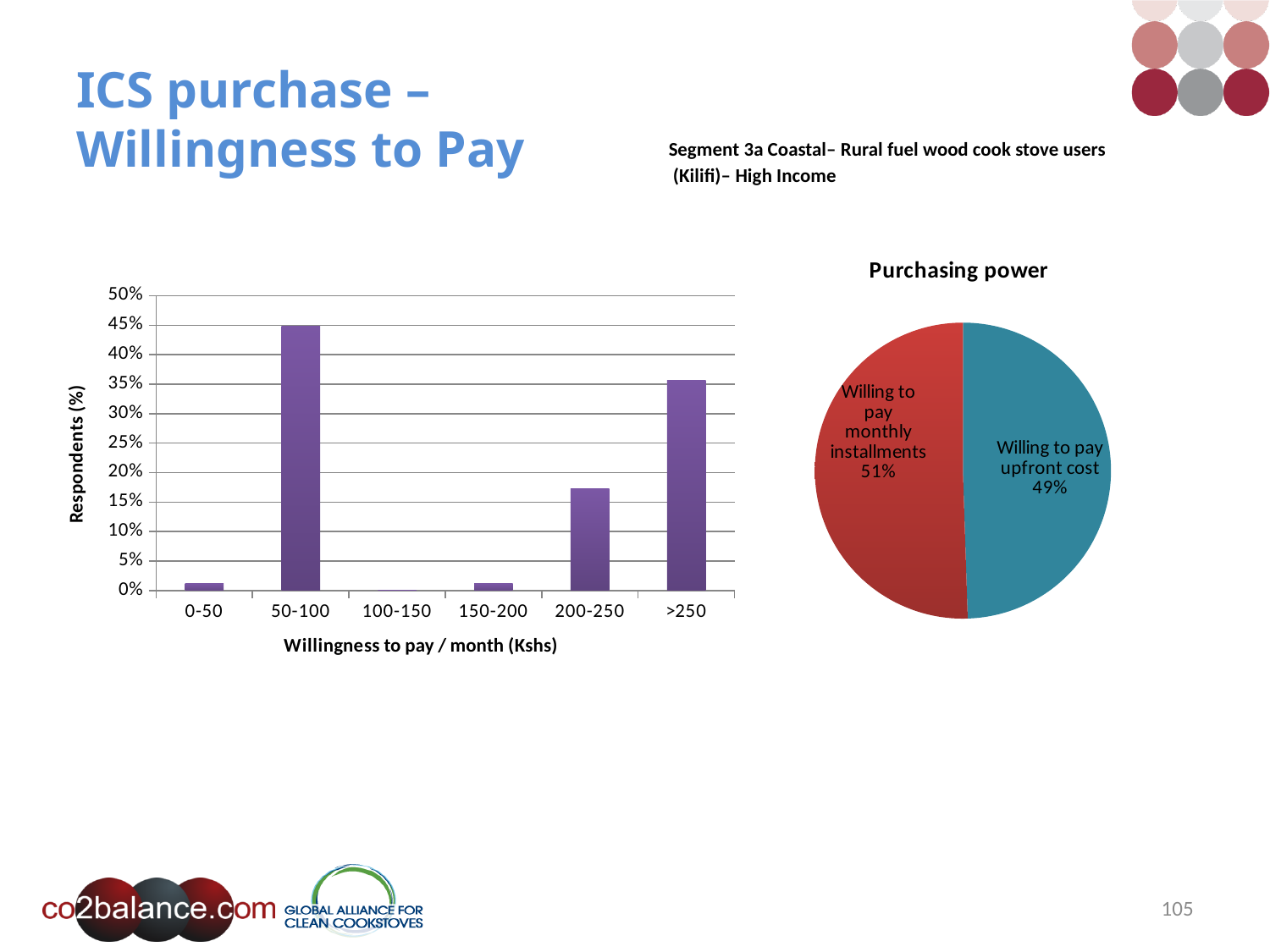
In the bar chart on the left, is the value for >250 greater or less than 30%? greater In the bar chart on the left, how many willingness-to-pay categories are shown on the x axis? 6 In the 'Purchasing power' pie chart, what share of respondents are willing to pay upfront cost? 49% In the 'Purchasing power' pie chart, what share of respondents are willing to pay monthly installments? 51% What is the x-axis title of the bar chart on the left? Willingness to pay / month (Kshs) In the bar chart on the left, which is larger, the value for 200-250 or the value for >250? >250 What kind of chart is the 'Purchasing power' chart? pie chart In the bar chart on the left, is the value for 200-250 greater or less than 20%? less In the 'Purchasing power' pie chart, how many slices are there? 2 In the bar chart on the left, which willingness-to-pay category has the highest share of respondents? 50-100 What kind of chart is the chart on the left of the slide? bar chart